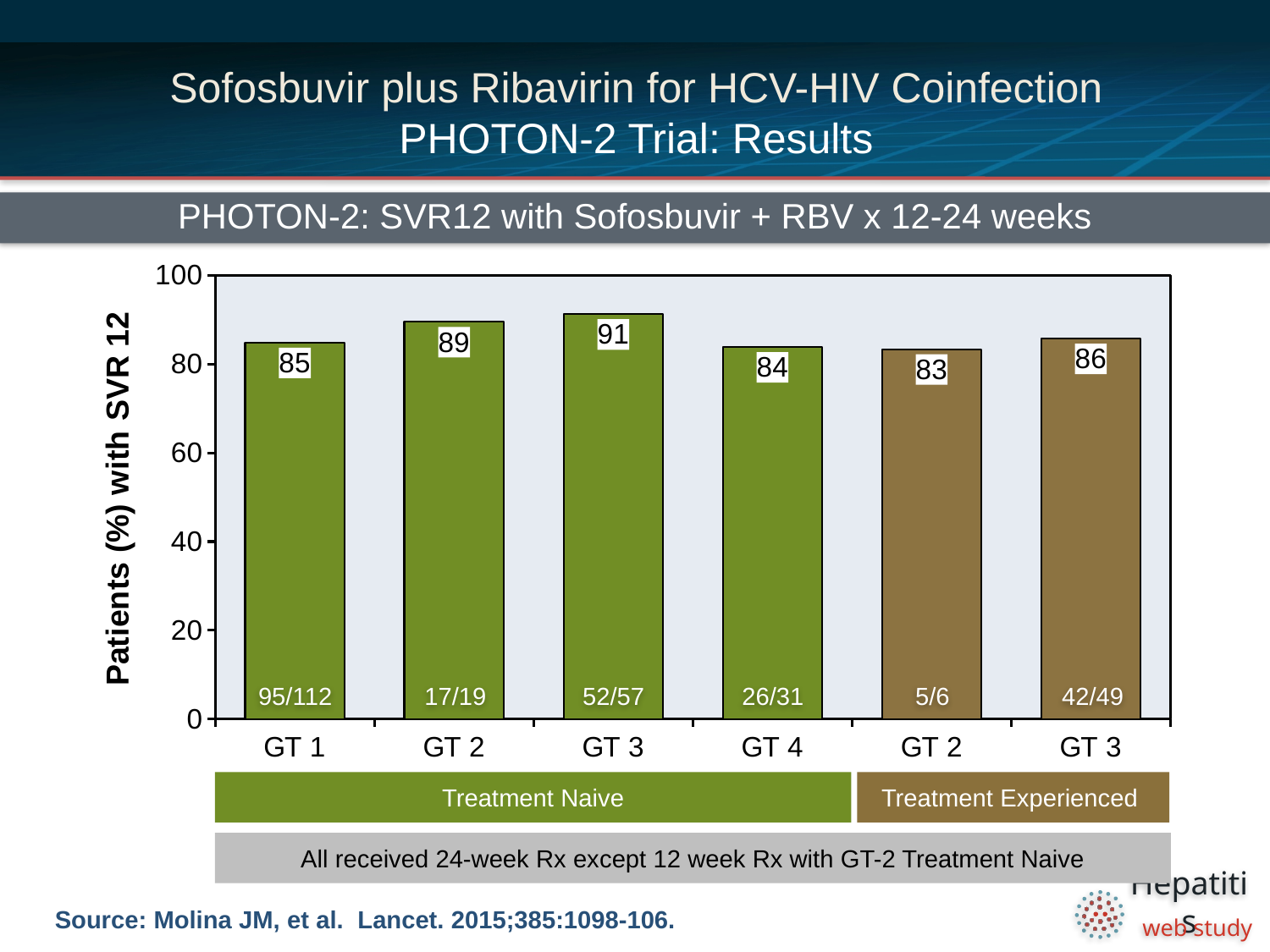
Is the SVR12 rate for GT 1 Treatment Naive greater or less than 80? greater What is the SVR12 rate for GT 3 in the Treatment Experienced group? 86 What fraction of patients is shown at the base of the GT 4 Treatment Naive bar? 26/31 What is the difference between the SVR12 rate for GT 3 Treatment Naive and GT 2 Treatment Experienced? 8 How many bars are plotted in the chart? 6 Which is larger, the SVR12 rate for GT 2 Treatment Naive or GT 2 Treatment Experienced? GT 2 Treatment Naive Which bar has the lowest SVR12 rate? GT 2 Treatment Experienced Which bar has the highest SVR12 rate? GT 3 Treatment Naive What is the title of the chart? PHOTON-2: SVR12 with Sofosbuvir + RBV x 12-24 weeks What kind of chart is shown on the slide? Bar chart What is the label of the y axis? Patients (%) with SVR 12 What is the SVR12 rate for GT 1 in the Treatment Naive group? 85